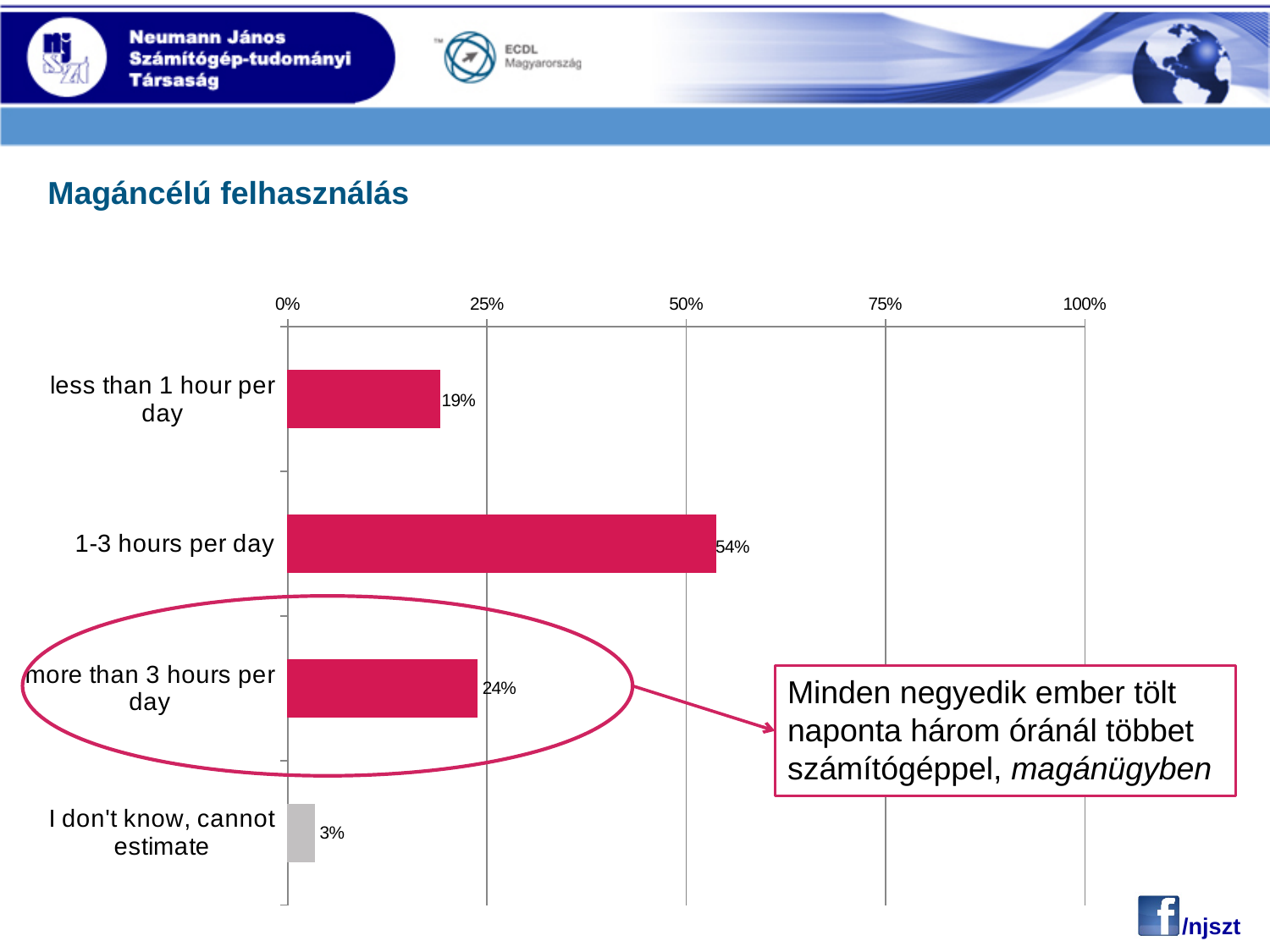
What is the value for "1-3 hours per day"? 54% What is the value for "less than 1 hour per day"? 19% Is the value for "1-3 hours per day" greater or less than 50%? greater Which category has the highest value? 1-3 hours per day What is the difference between the values for "1-3 hours per day" and "more than 3 hours per day"? 30% How many categories are shown in the chart? 4 What is the value for "more than 3 hours per day"? 24% Which category is circled on the chart? more than 3 hours per day Which category has the lowest value? I don't know, cannot estimate What kind of chart is shown on the slide? bar chart Which is larger: the value for "less than 1 hour per day" or "more than 3 hours per day"? more than 3 hours per day What is the value for "I don't know, cannot estimate"? 3%